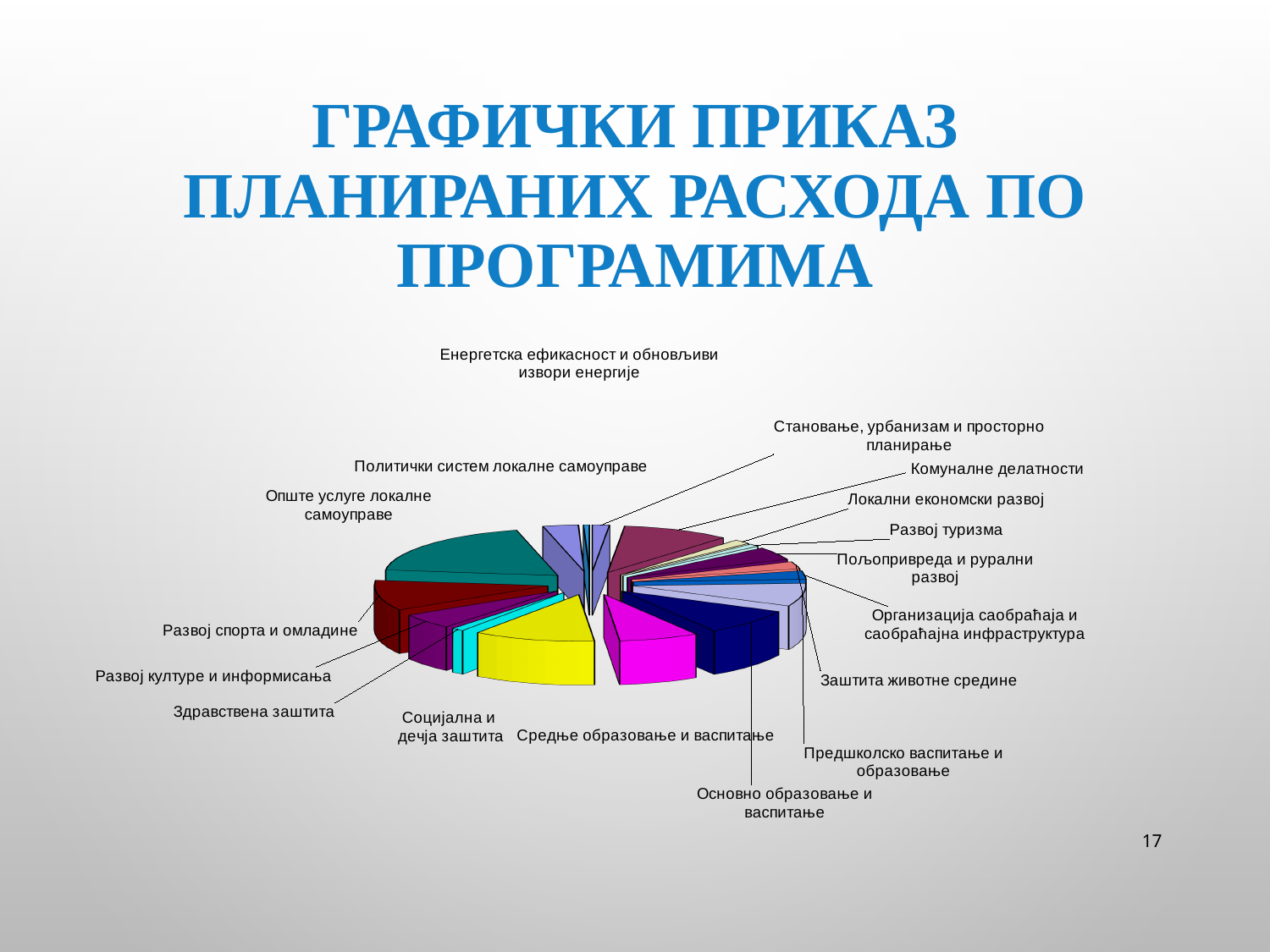
What kind of chart is shown on the slide? Pie chart Which slice is larger: Социјална и дечја заштита or Здравствена заштита? Социјална и дечја заштита Which slice is larger: Средње образовање и васпитање or Пољопривреда и рурални развој? Средње образовање и васпитање Which slice is larger: Опште услуге локалне самоуправе or Развој туризма? Опште услуге локалне самоуправе What is the title of the slide containing the pie chart? ГРАФИЧКИ ПРИКАЗ ПЛАНИРАНИХ РАСХОДА ПО ПРОГРАМИМА How many program categories are labelled on the pie chart? 17 Which colour is the slice for Социјална и дечја заштита? Yellow